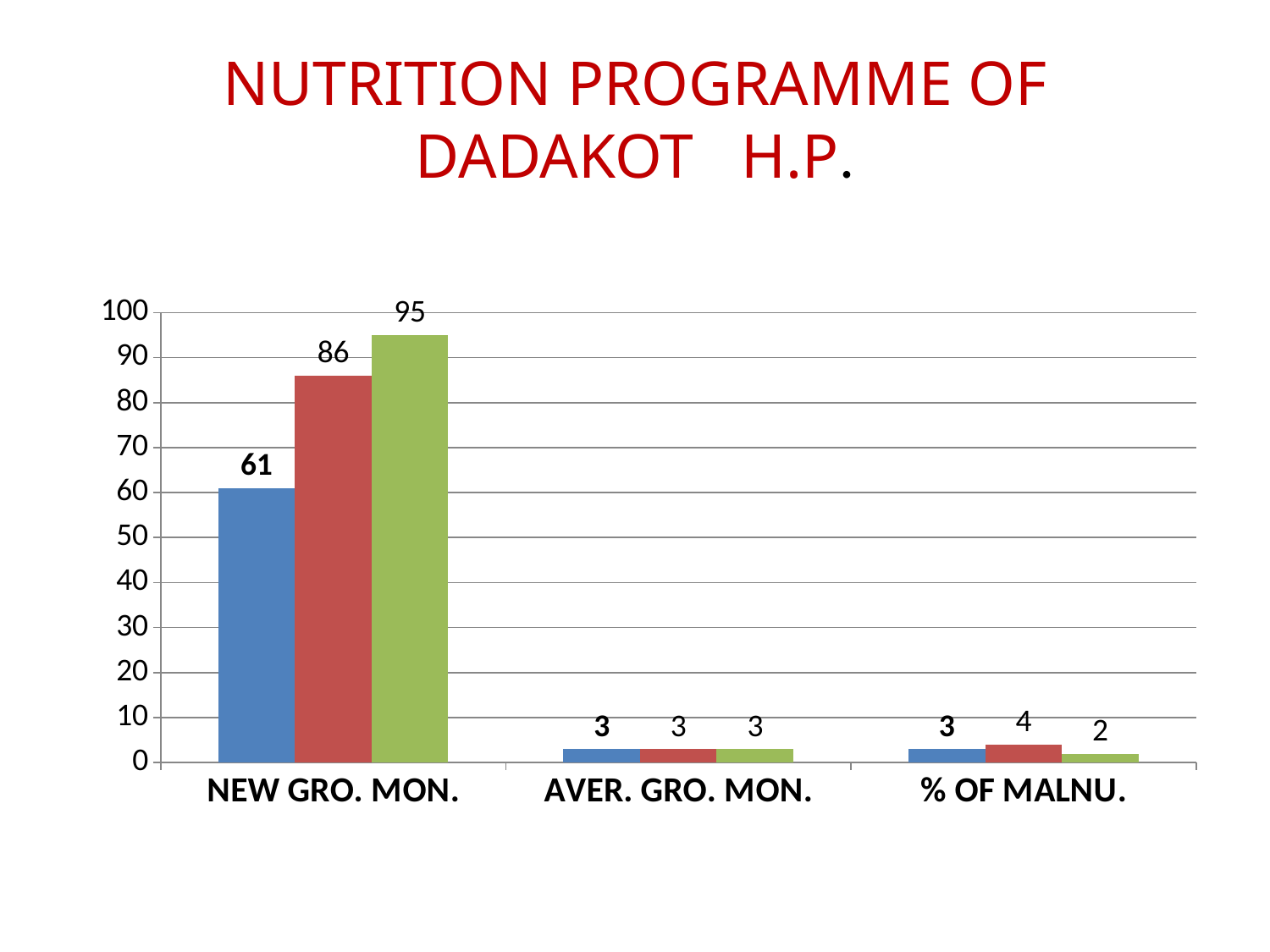
What is the value of the blue bar for NEW GRO. MON.? 61 What is the difference between the red bar and the blue bar for NEW GRO. MON.? 25 What is the difference between the green bar and the blue bar for NEW GRO. MON.? 34 What is the value of the green bar for % OF MALNU.? 2 Which is larger for NEW GRO. MON., the red bar or the green bar? the green bar What is the value of the red bar for NEW GRO. MON.? 86 What is the value of the red bar for % OF MALNU.? 4 What is the title of the slide? NUTRITION PROGRAMME OF DADAKOT H.P. Which category has the highest bars in the chart? NEW GRO. MON. How many categories are shown on the x axis? 3 What kind of chart is shown on the slide? bar chart What is the value of the green bar for NEW GRO. MON.? 95